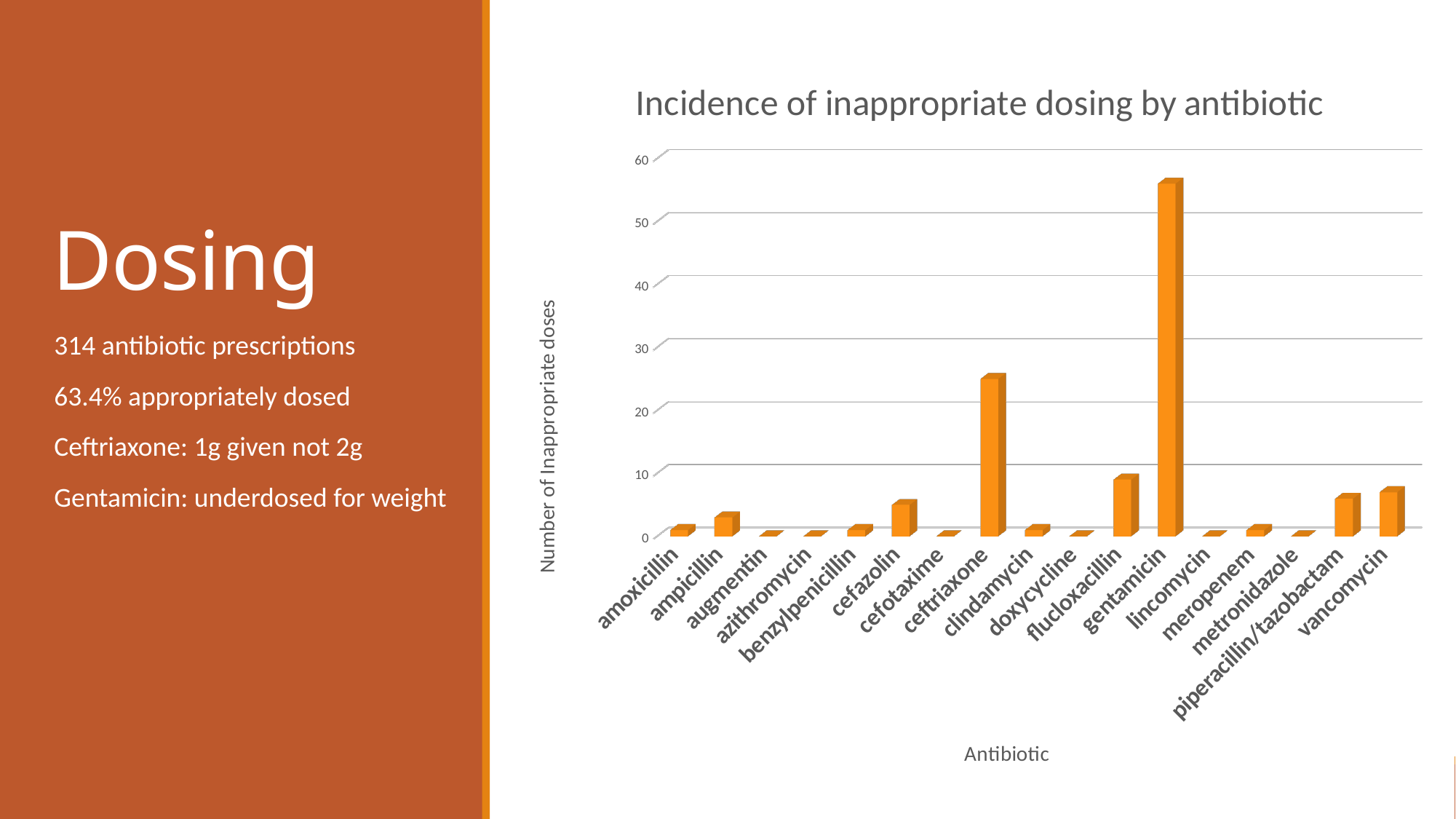
Is the value for ceftriaxone greater or less than 20? greater Which has more inappropriate doses, gentamicin or ceftriaxone? gentamicin What kind of chart is shown on the slide? bar chart Is the value for vancomycin greater or less than 10? less What is the label of the vertical axis of the chart? Number of Inappropriate doses Is the value for ceftriaxone greater or less than 30? less Which has more inappropriate doses, ceftriaxone or flucloxacillin? ceftriaxone How many antibiotics are shown on the x axis of the chart? 17 What is the title of the chart? Incidence of inappropriate dosing by antibiotic Which antibiotic has the highest number of inappropriate doses? gentamicin